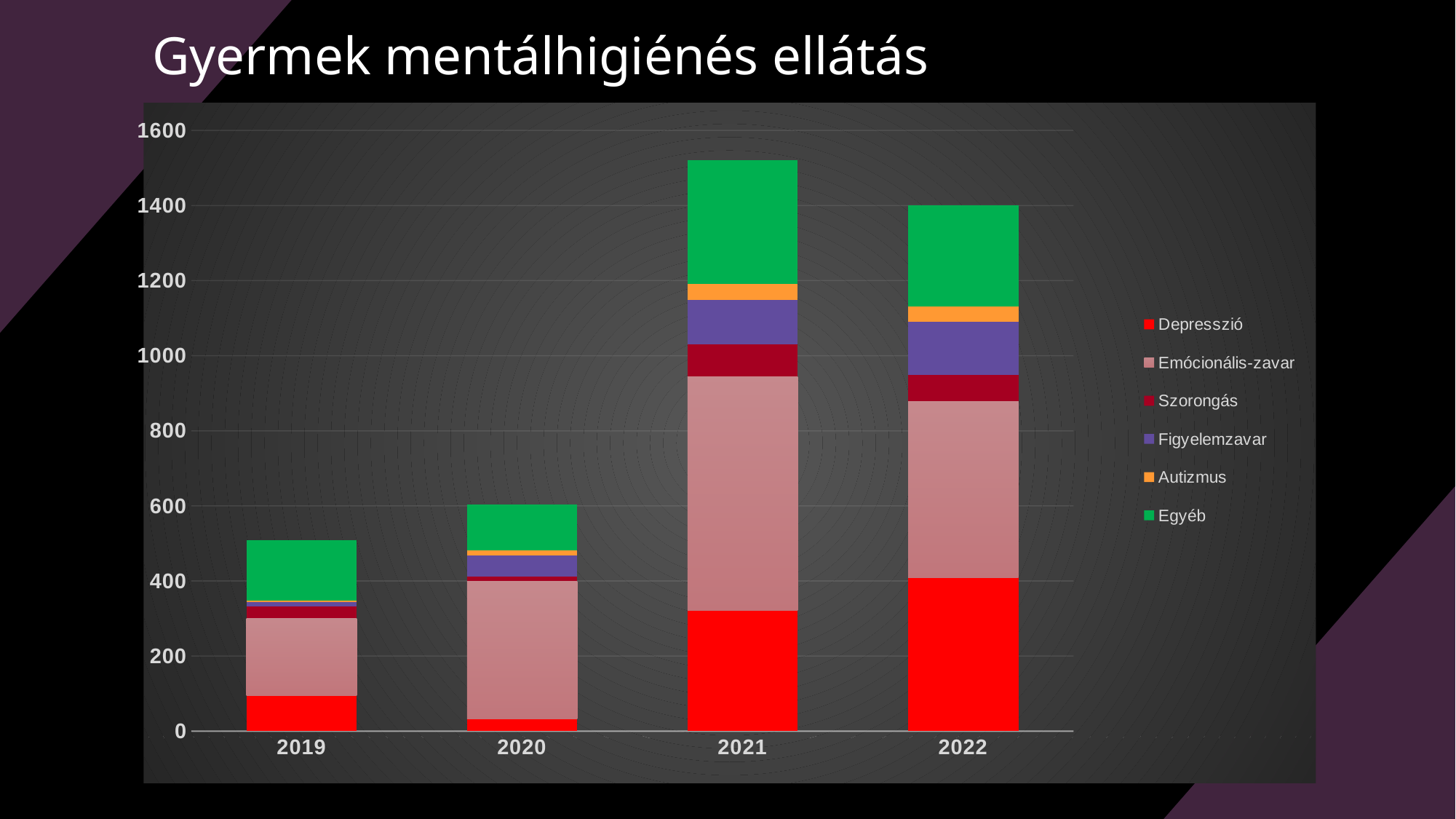
How many series does the chart's legend list? 6 What is the title of the slide containing the chart? Gyermek mentálhigiénés ellátás Is the total height of the 2019 bar greater or less than 600? less Which year has the larger Depresszió segment, 2021 or 2022? 2022 How many years are shown on the x axis of the chart? 4 What kind of chart is shown on the slide? stacked bar chart Do the total bar heights rise or fall from 2019 to 2021? rise Is the total height of the 2021 bar greater or less than 1400? greater Is the Depresszió value for 2019 greater or less than 200? less Which year has the tallest stacked bar in total? 2021 Which year has the shortest stacked bar in total? 2019